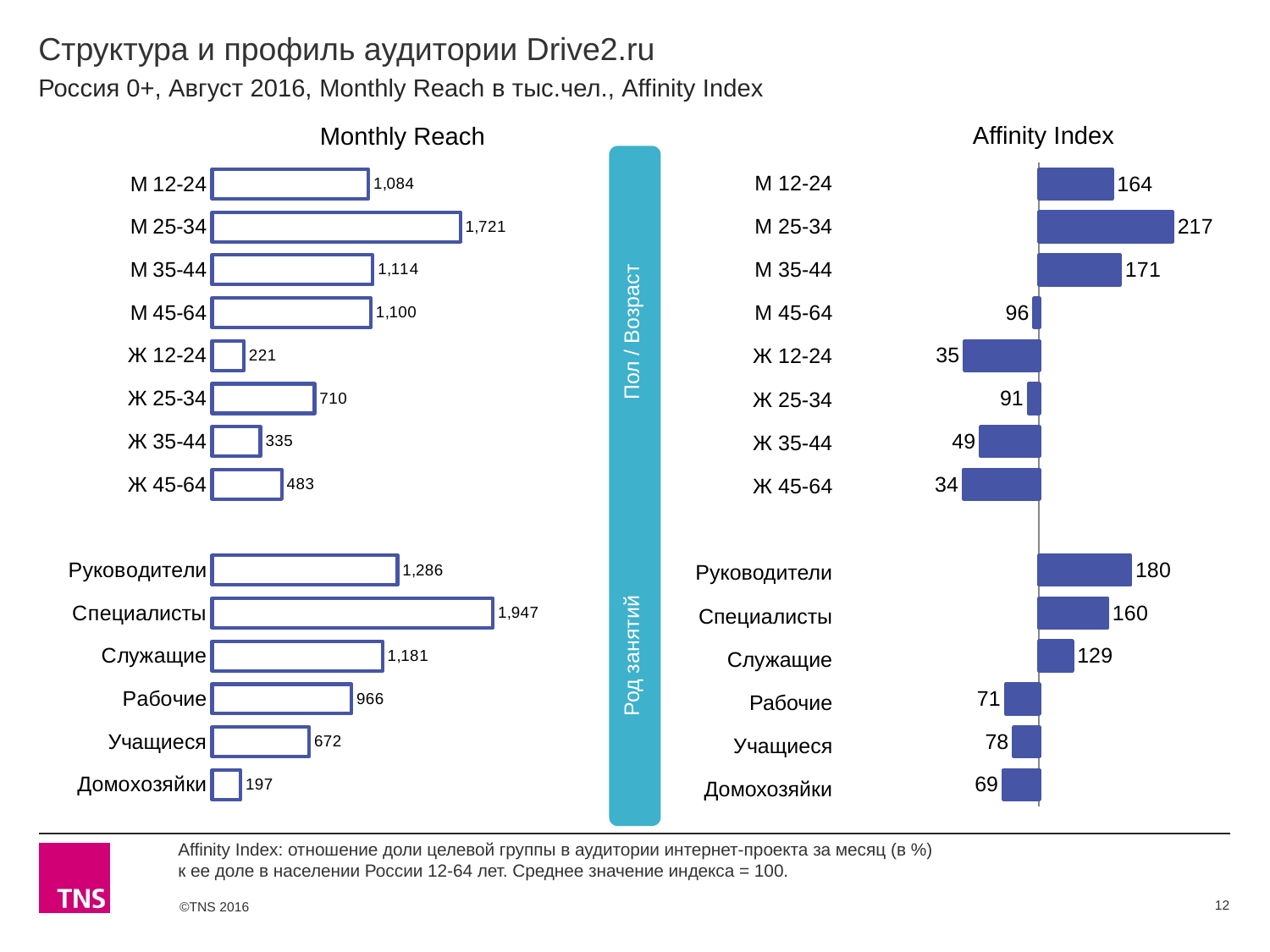
In the Monthly Reach chart, what is the difference between Специалисты and Руководители? 661 In the Monthly Reach chart, what is the value for М 25-34? 1,721 In the Affinity Index chart, which is larger: Ж 25-34 or Ж 35-44? Ж 25-34 In the Monthly Reach chart, which category has the lowest value? Домохозяйки In the Monthly Reach chart, how many categories are plotted? 14 In the Affinity Index chart, what is the value for Руководители? 180 In the Affinity Index chart, which category has the lowest value? Ж 45-64 In the Affinity Index chart, what is the difference between М 12-24 and М 45-64? 68 In the Monthly Reach chart, which category has the highest value? Специалисты What kind of chart is the Affinity Index chart? Bar chart In the Monthly Reach chart, what is the value for Ж 35-44? 335 In the Affinity Index chart, which category has the highest value? М 25-34